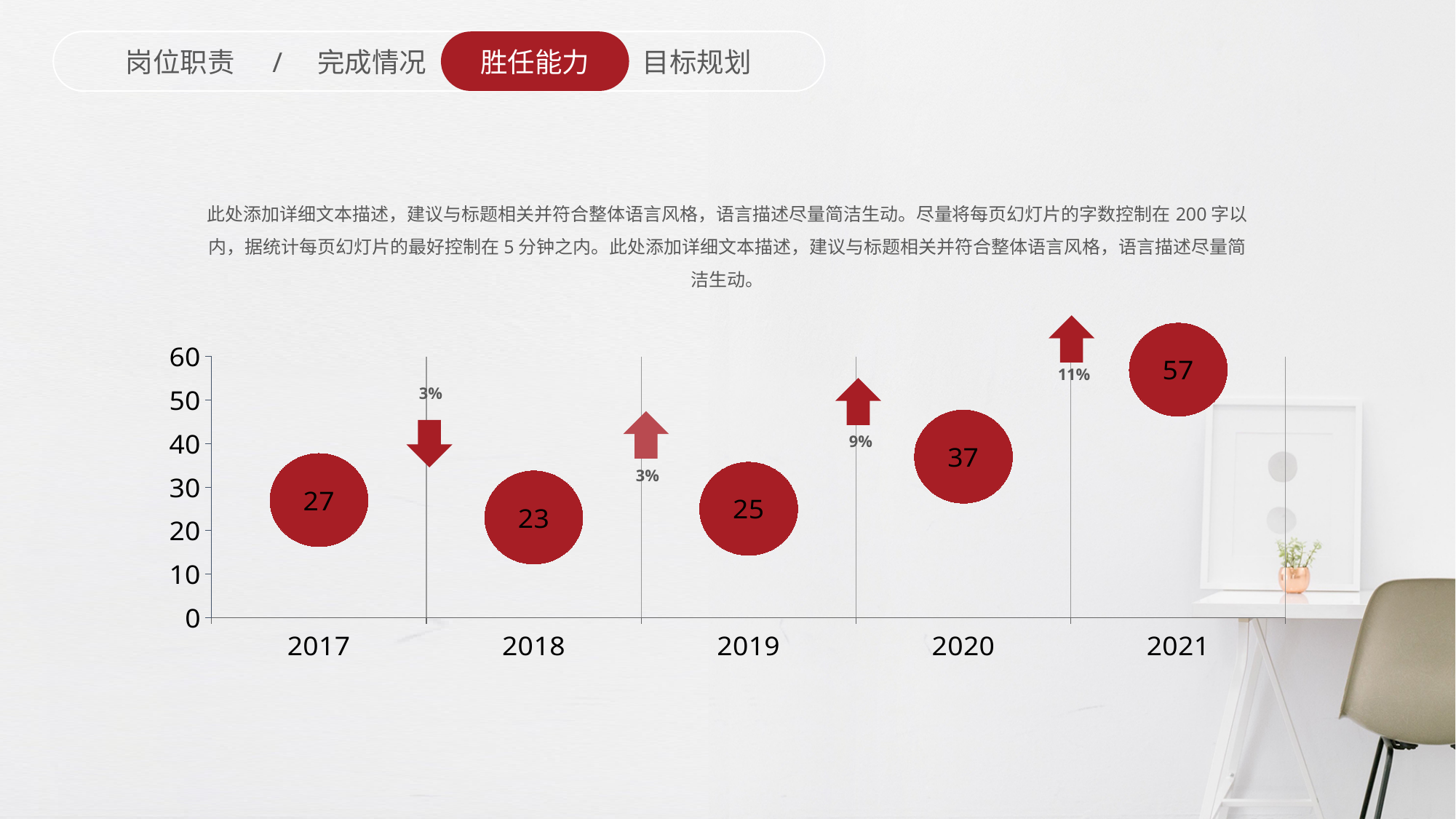
Do the values rise or fall from 2018 to 2021? rise What is the value for 2020? 37 Which is larger, the value for 2017 or the value for 2019? 2017 Which year has the highest value? 2021 What is the value for 2017? 27 What is the value for 2018? 23 What is the value for 2021? 57 What percentage change is shown by the arrow between 2020 and 2021? 11% How many years are plotted on the x axis? 5 Which year has the lowest value? 2018 What is the maximum value shown on the y axis? 60 What is the difference between the values for 2021 and 2020? 20